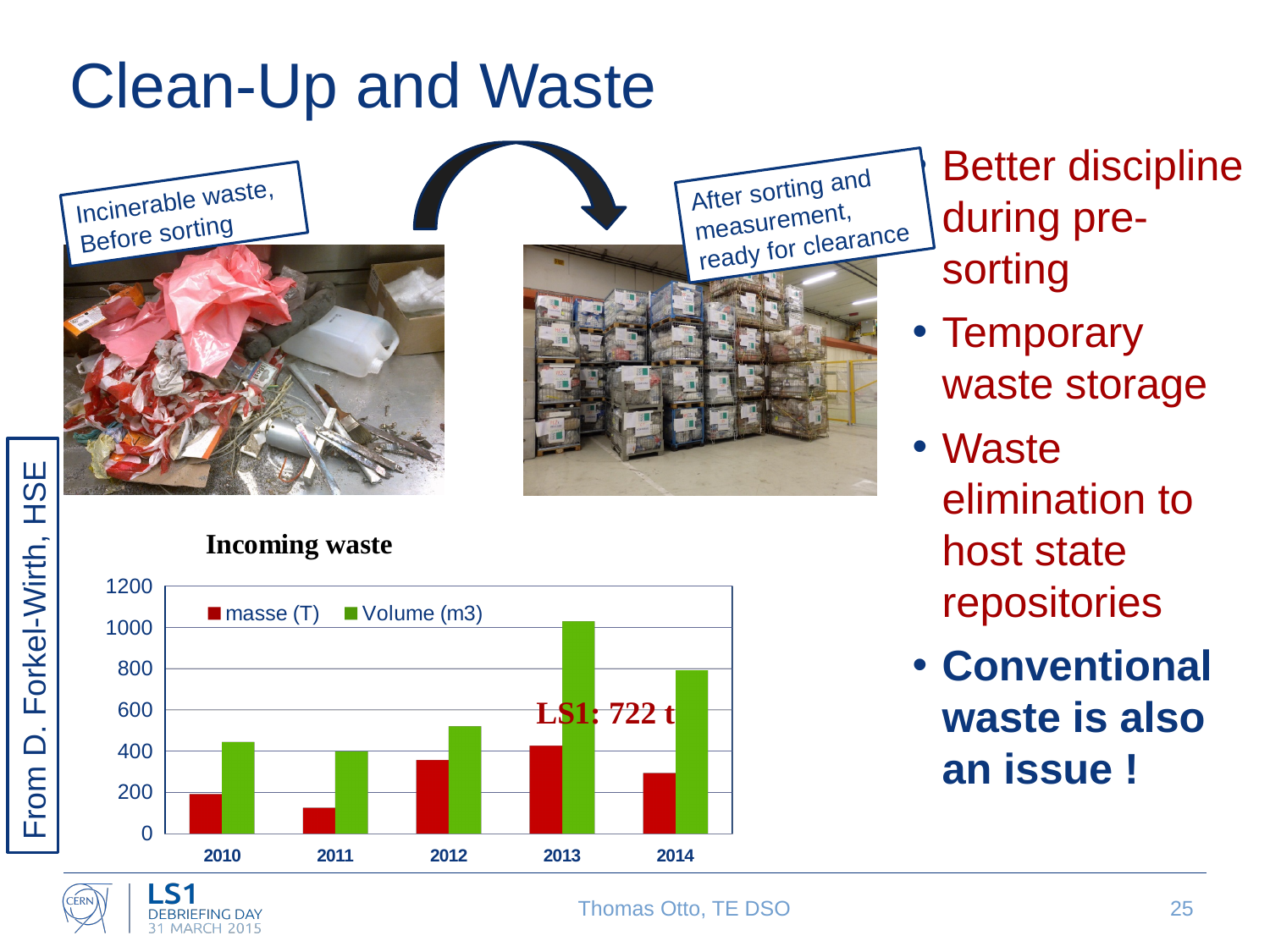
In the 'Incoming waste' chart, is the masse (T) for 2011 greater or less than 200? less In the 'Incoming waste' chart, is the Volume (m3) for 2014 greater or less than 600? greater In the 'Incoming waste' chart, is the masse (T) larger in 2012 or in 2014? 2012 In the 'Incoming waste' chart, is the Volume (m3) larger in 2013 or in 2014? 2013 What colour represents the Volume (m3) series in the 'Incoming waste' chart? green In the 'Incoming waste' chart, which year has the highest masse (T)? 2013 How many years are shown on the x axis of the 'Incoming waste' chart? 5 In the 'Incoming waste' chart, which year has the lowest masse (T)? 2011 How many series does the legend of the 'Incoming waste' chart list? 2 In the 'Incoming waste' chart, is the Volume (m3) for 2013 greater or less than 800? greater In the 'Incoming waste' chart, which year has the highest Volume (m3)? 2013 What kind of chart is the 'Incoming waste' chart? bar chart